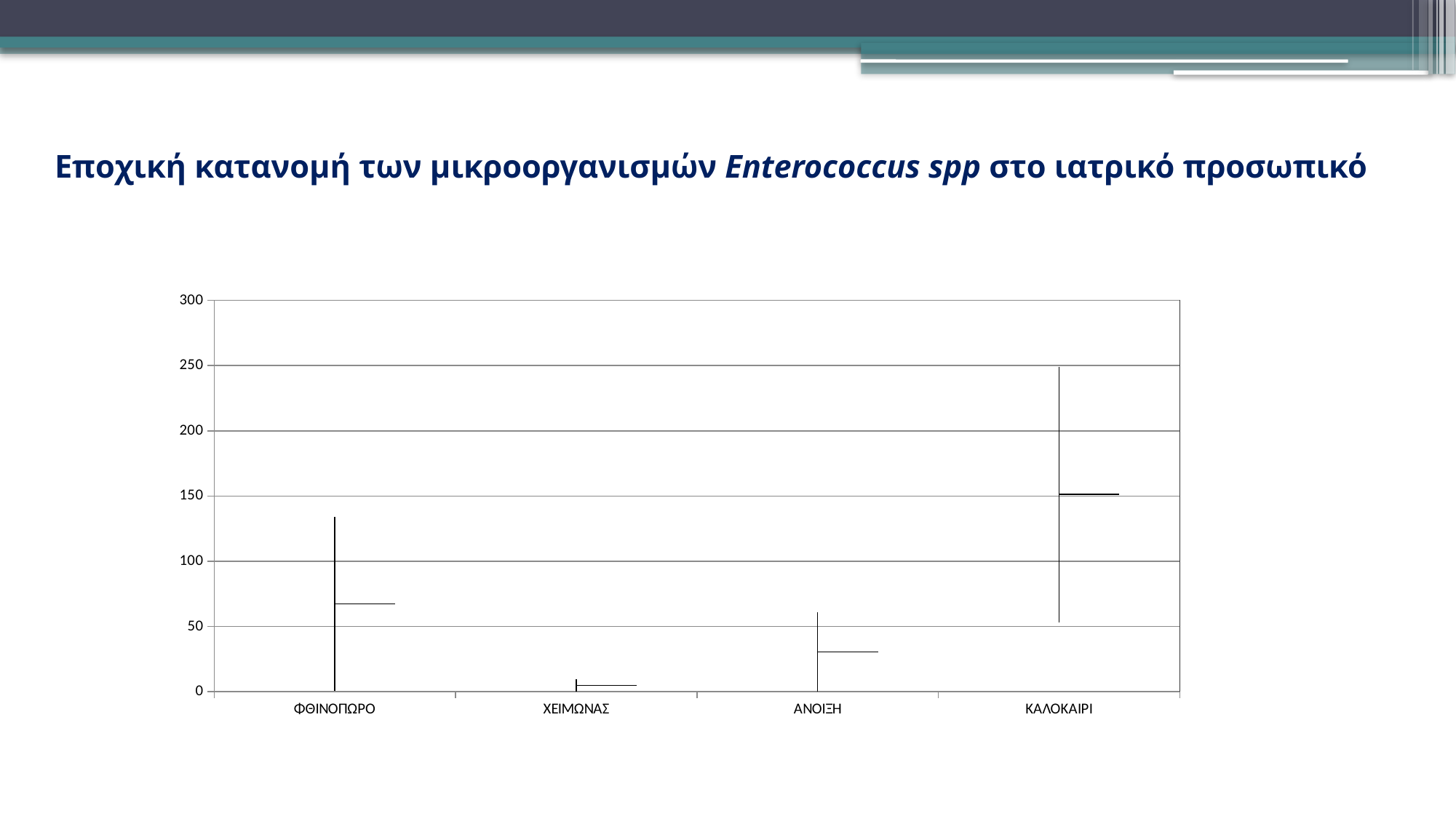
Is the horizontal marker value for ΚΑΛΟΚΑΙΡΙ greater or less than 100? greater How many categories are shown on the x axis of the chart? 4 What is the title of the slide containing the chart? Εποχική κατανομή των μικροοργανισμών Enterococcus spp στο ιατρικό προσωπικό Is the top of the range for ΚΑΛΟΚΑΙΡΙ greater or less than 200? greater What kind of chart is shown on the slide? stock (high-low-close) chart Which category has the lowest values on the chart? ΧΕΙΜΩΝΑΣ Which category reaches a higher value, ΦΘΙΝΟΠΩΡΟ or ΑΝΟΙΞΗ? ΦΘΙΝΟΠΩΡΟ What is the maximum value shown on the vertical axis of the chart? 300 Is the top of the range for ΦΘΙΝΟΠΩΡΟ greater or less than 100? greater Which category reaches the highest value on the chart? ΚΑΛΟΚΑΙΡΙ